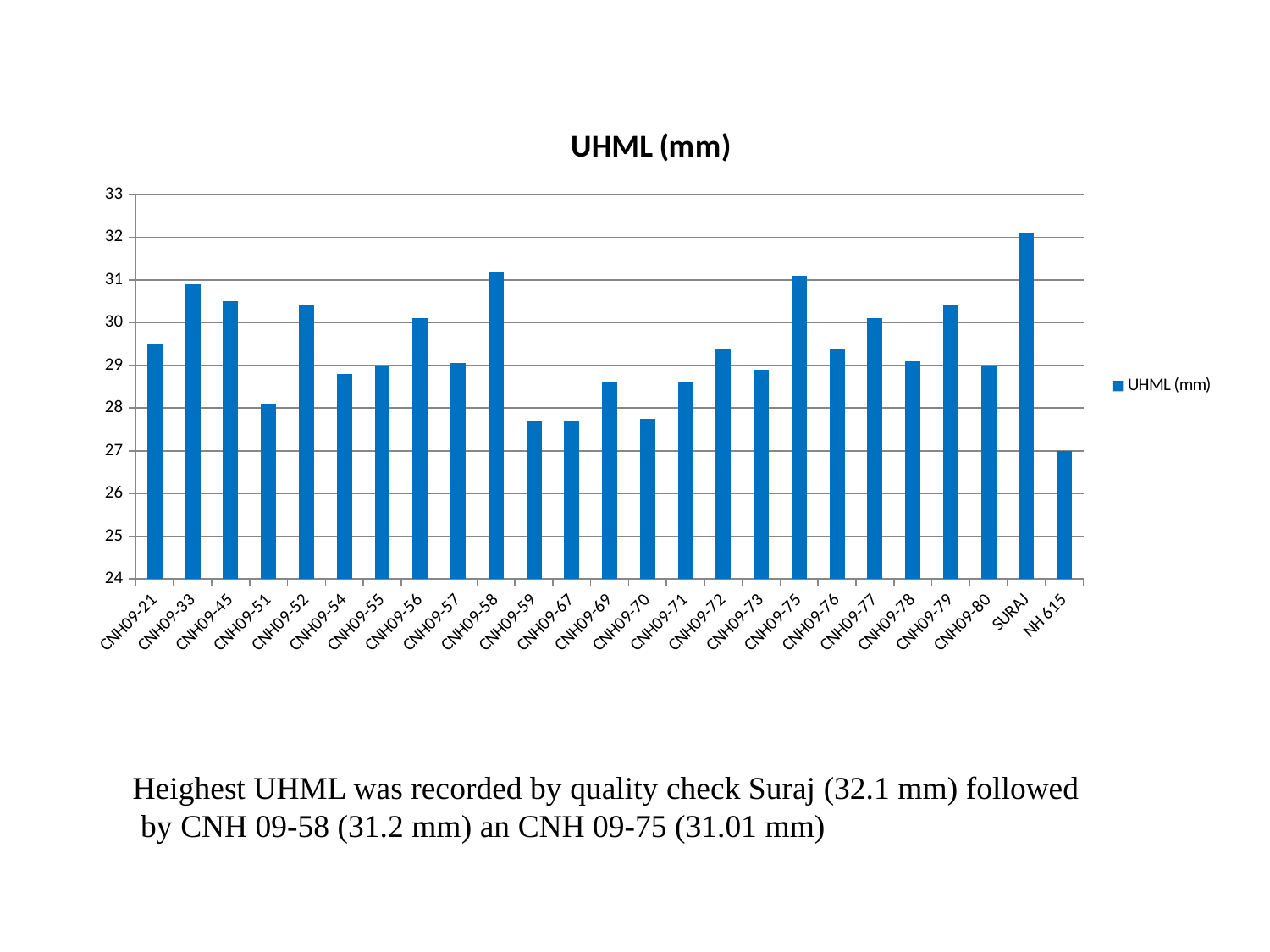
How many categories are plotted along the x axis? 25 Is the value for NH 615 greater or less than 28? less What is the title of the chart? UHML (mm) Is the value for CNH09-51 greater or less than 29? less What kind of chart is shown on the slide? bar chart What UHML value was recorded for Suraj, according to the slide? 32.1 mm Is the value for CNH09-21 greater or less than 29? greater Which has the larger UHML value, CNH09-52 or CNH09-54? CNH09-52 How many series does the legend list? 1 Which category has the highest UHML value? SURAJ Which category has the lowest UHML value? NH 615